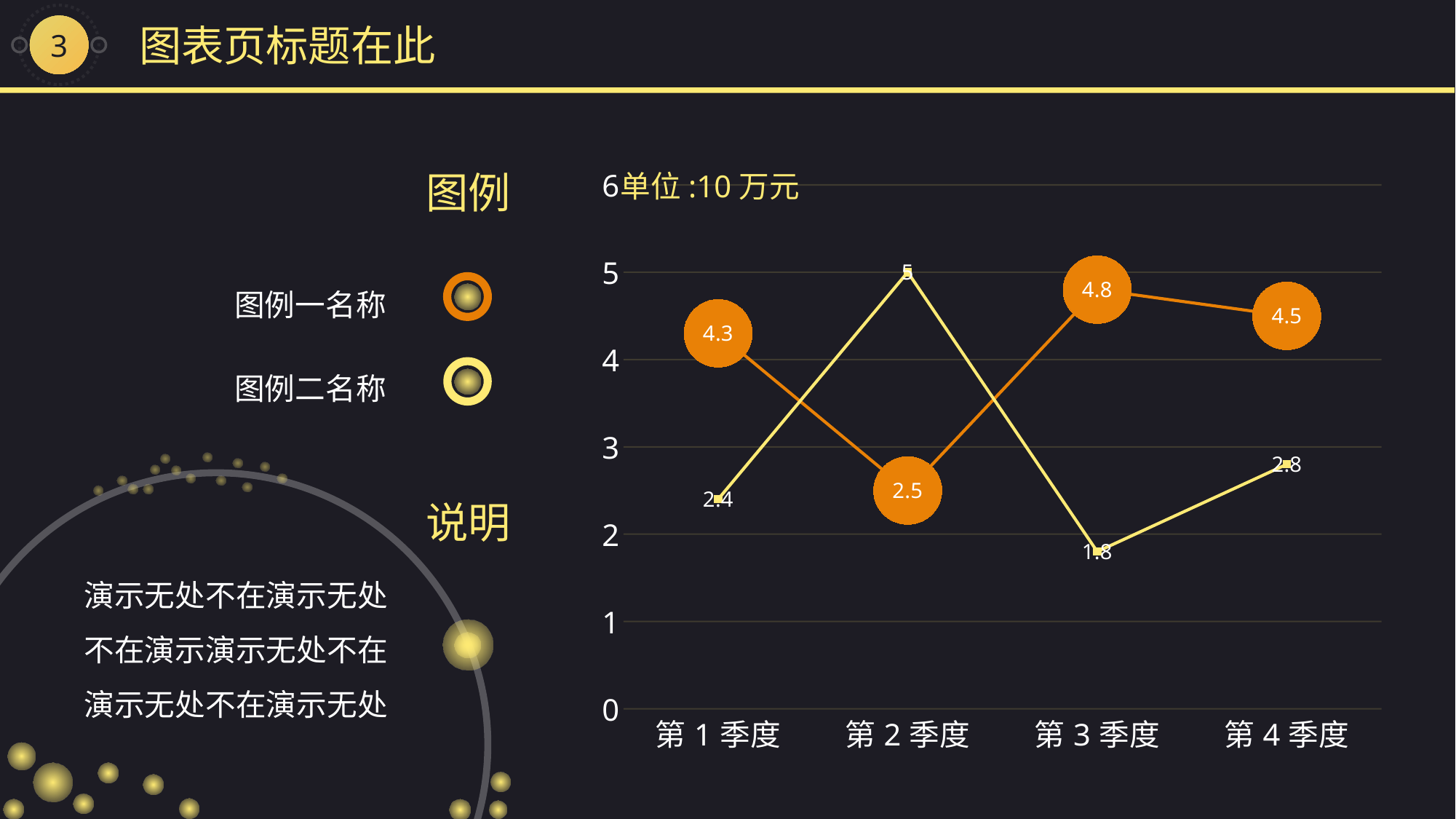
What is the value of 图例一名称 in 第 3 季度? 4.8 How many series does the legend list? 2 What unit is stated above the chart? 10 万元 What is the value of 图例一名称 in 第 1 季度? 4.3 How many quarters are shown on the x axis? 4 What is the value of 图例二名称 in 第 2 季度? 5 What type of chart is shown on the slide? line chart In which quarter does 图例二名称 reach its highest value? 第 2 季度 Which series has the larger value in 第 1 季度, 图例一名称 or 图例二名称? 图例一名称 In which quarter does 图例一名称 have its lowest value? 第 2 季度 What is the difference between 图例一名称 and 图例二名称 in 第 3 季度? 3 What is the value of 图例二名称 in 第 4 季度? 2.8